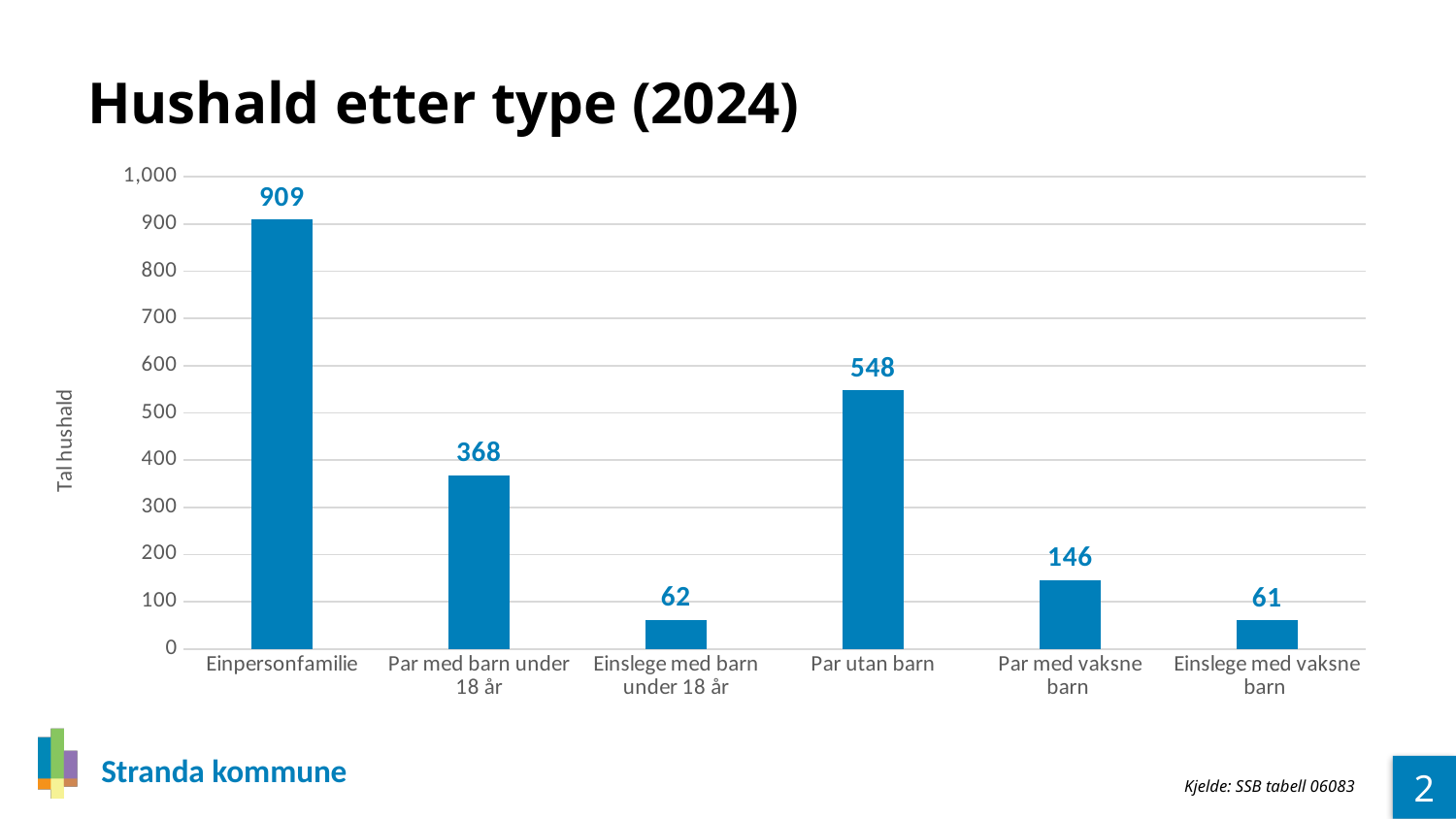
What is the value for Par utan barn? 548 What is the title of the chart? Hushald etter type (2024) What is the value for Einpersonfamilie? 909 What kind of chart is shown on the slide? bar chart What is the value for Einslege med vaksne barn? 61 Is the value for Par med vaksne barn greater or less than 200? less Which is larger, the value for Par med barn under 18 år or the value for Par utan barn? Par utan barn What is the difference between the values for Par med barn under 18 år and Par med vaksne barn? 222 Which household type has the highest value? Einpersonfamilie How many household types are shown in the chart? 6 What is the difference between the values for Einpersonfamilie and Par utan barn? 361 Which household type has the lowest value? Einslege med vaksne barn